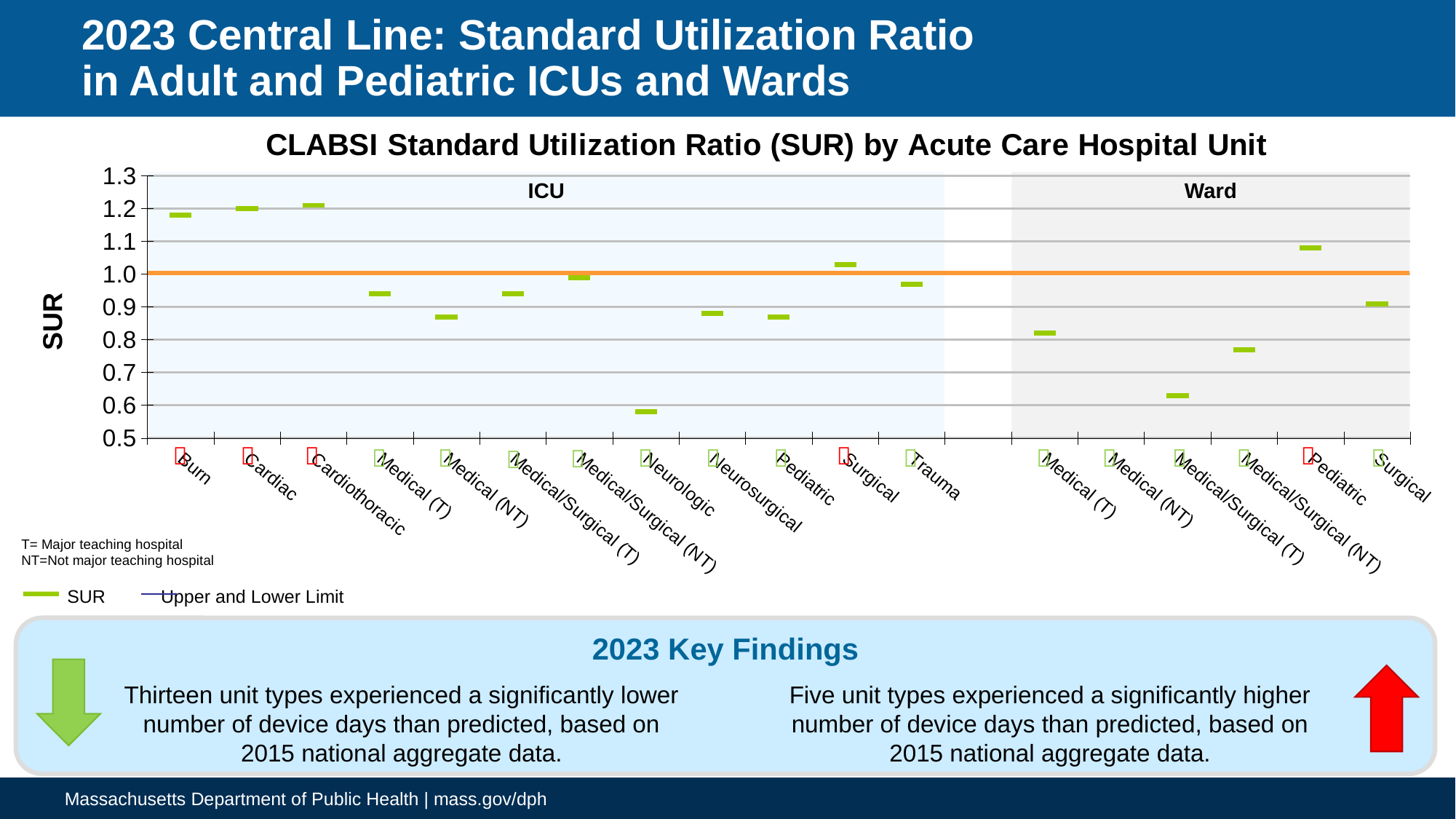
Is the SUR for the Medical/Surgical (T) ward greater or less than 0.7? less What is the label on the vertical axis of the chart? SUR Is the SUR for the Neurologic ICU greater or less than 0.7? less Which has a higher SUR, the Burn ICU or the Medical (T) ward? Burn ICU Is the SUR for the Pediatric ward greater or less than 1.0? greater How many unit types are plotted in the ICU section of the chart? 12 What is the title of the chart? CLABSI Standard Utilization Ratio (SUR) by Acute Care Hospital Unit How many unit types are plotted in the Ward section of the chart? 6 Which has a higher SUR, the Pediatric ward or the Surgical ward? Pediatric ward How many entries does the chart legend list? 2